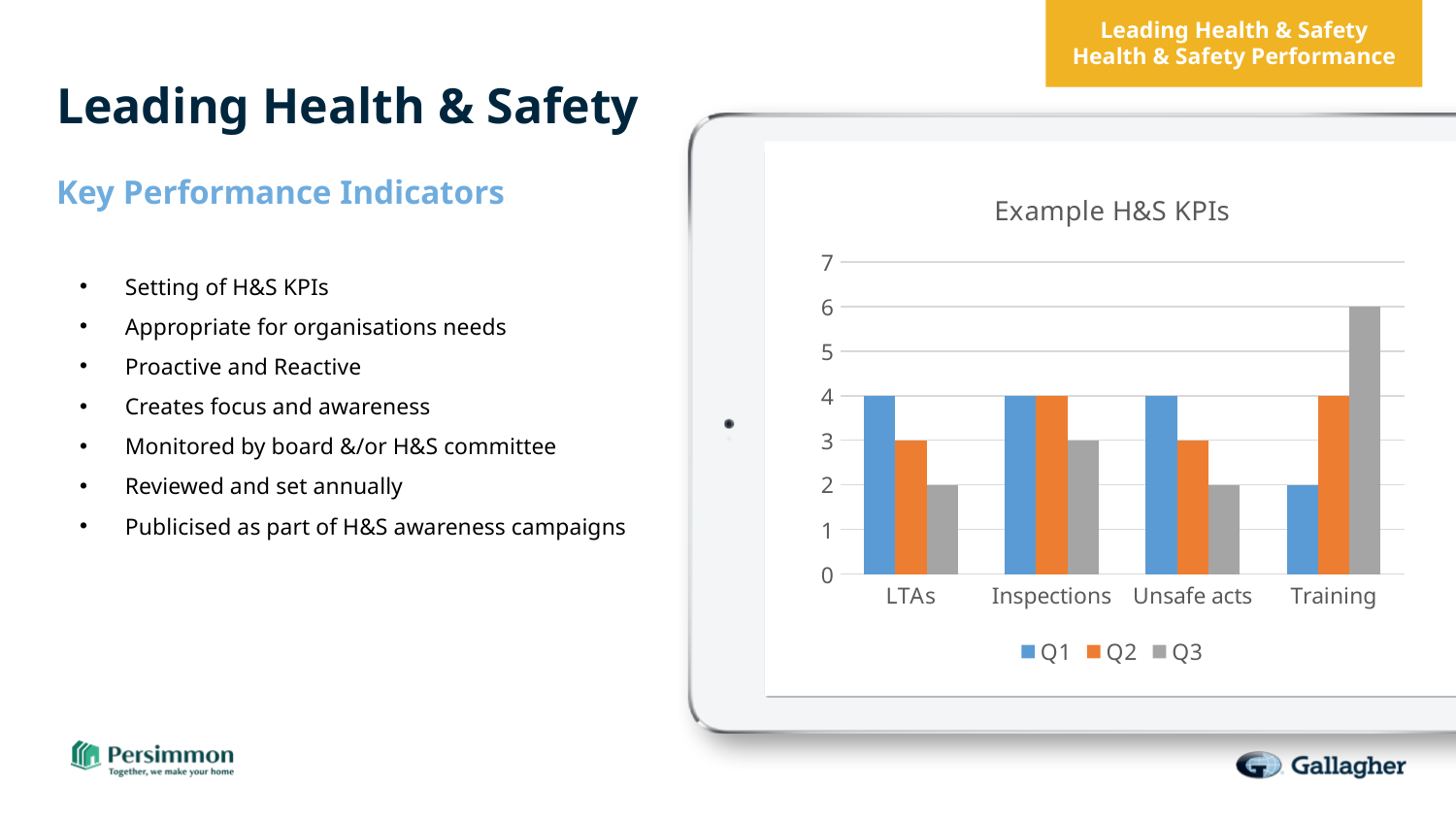
What is the Q1 value for LTAs? 4 What is the title of the chart? Example H&S KPIs What is the Q2 value for Unsafe acts? 3 How many categories are shown on the x axis? 4 Which category has the lowest Q1 value? Training What is the difference between the Q3 value for Training and the Q3 value for LTAs? 4 Which is larger, the Q1 value for Unsafe acts or the Q3 value for Unsafe acts? Q1 Do the Q3 values rise or fall from Unsafe acts to Training? rise How many series does the legend list? 3 Which category has the highest Q3 value? Training What type of chart is shown on the slide? bar chart What is the Q3 value for Training? 6